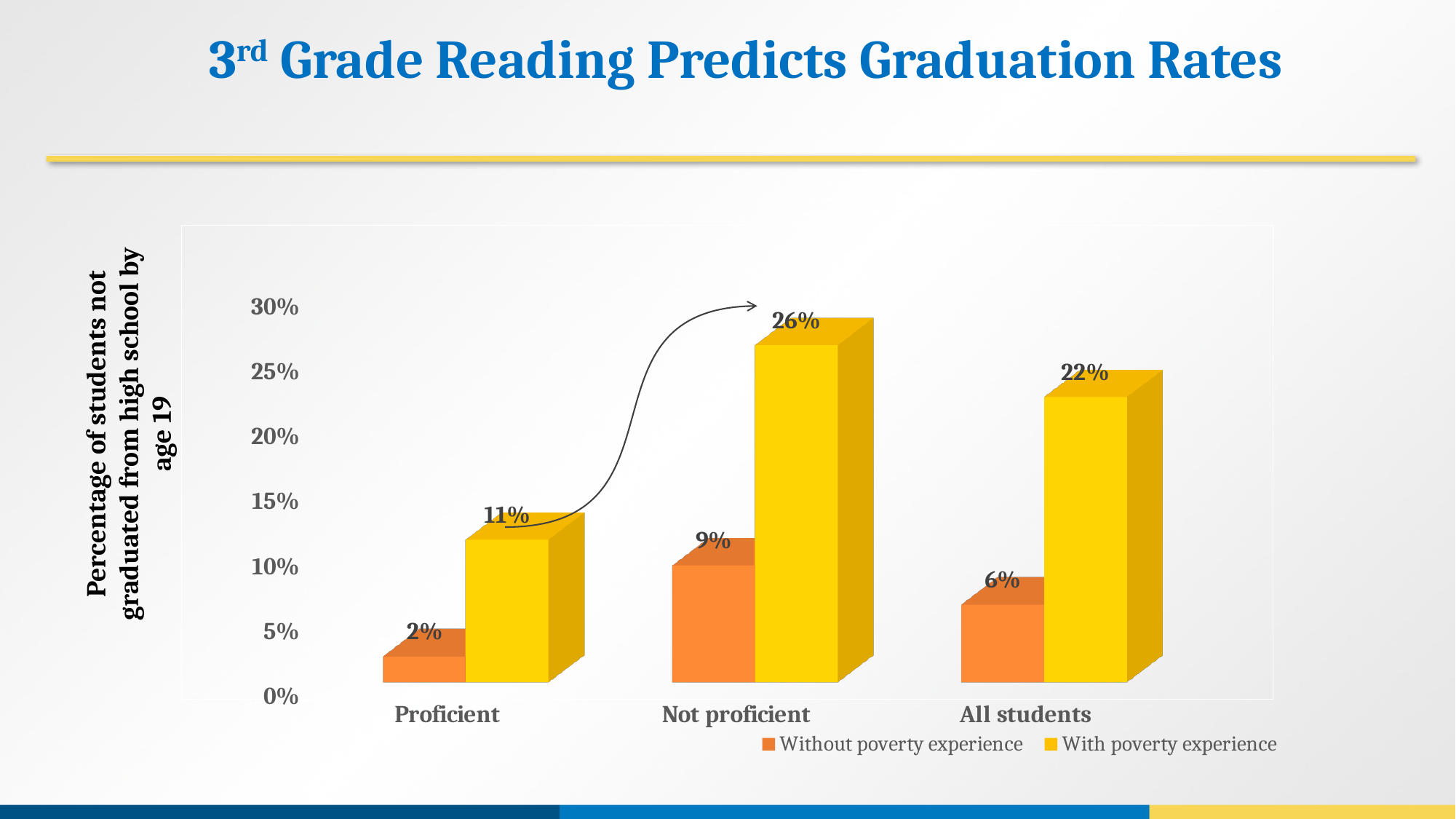
What is the difference between the With poverty experience and Without poverty experience values for Not proficient students? 17% How many categories are shown on the x axis? 3 How many series does the legend list? 2 Which category has the highest value for the With poverty experience series? Not proficient Which is larger: the Without poverty experience value for Not proficient or for All students? Not proficient What colour represents the With poverty experience series? Yellow Which category has the lowest value for the Without poverty experience series? Proficient What is the value for All students with poverty experience? 22% What kind of chart is shown on the slide? Bar chart What is the value for Not proficient students with poverty experience? 26% What is the value for Proficient students without poverty experience? 2% Is the value for Proficient students with poverty experience greater or less than 10%? greater